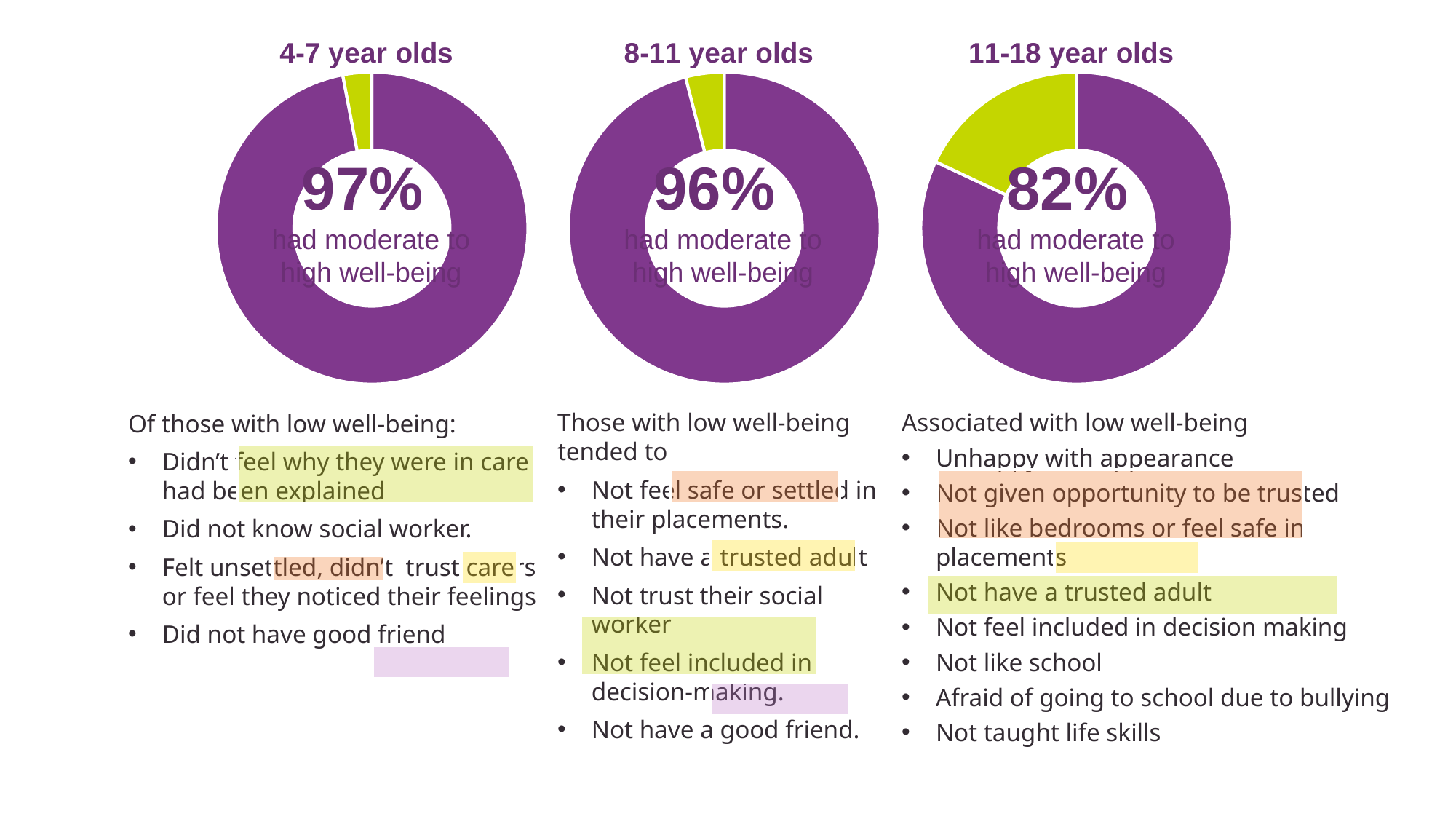
How many donut charts are shown on the slide? 3 In the 11-18 year olds chart, what percentage had moderate to high well-being? 82% Which age group chart shows the lowest percentage with moderate to high well-being? 11-18 year olds In the 8-11 year olds chart, what percentage had moderate to high well-being? 96% What kind of chart is used to show the well-being percentages for each age group? Donut (pie) chart Which age group chart shows the highest percentage with moderate to high well-being? 4-7 year olds What is the difference between the percentage shown in the 4-7 year olds chart and the 11-18 year olds chart? 15% Is the percentage with moderate to high well-being larger in the 4-7 year olds chart or the 8-11 year olds chart? 4-7 year olds Which chart has the largest green segment? 11-18 year olds What is the difference between the percentage shown in the 8-11 year olds chart and the 11-18 year olds chart? 14% In the 4-7 year olds chart, what percentage had moderate to high well-being? 97% What colour represents the portion with moderate to high well-being in the donut charts? Purple